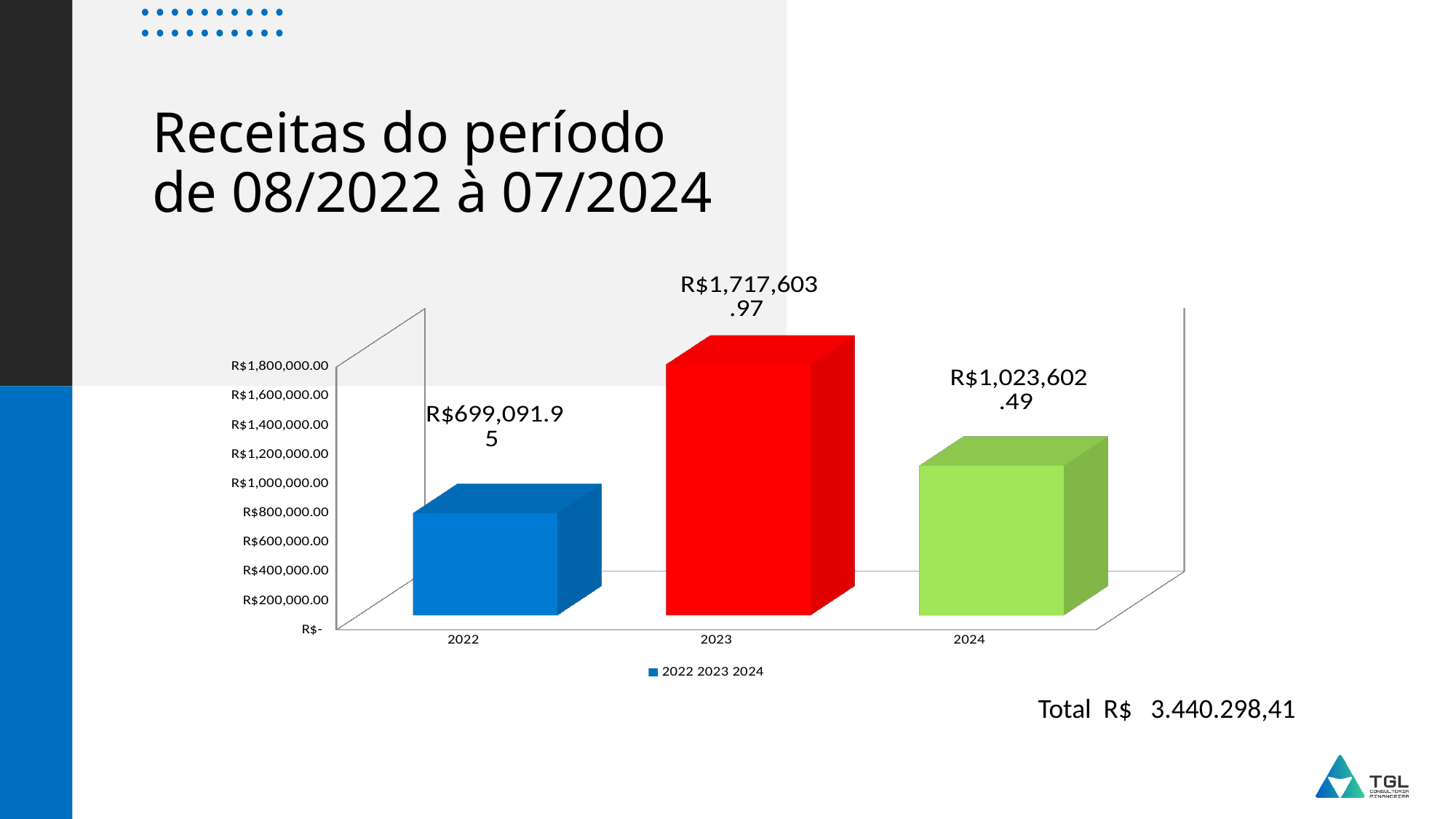
Is the value for 2023 greater or less than R$1,600,000.00? greater What is the value for 2023? R$1,717,603.97 Which year has the highest value? 2023 Does the value rise or fall from 2023 to 2024? fall How many years are shown on the x axis? 3 What is the difference between the values for 2023 and 2022? R$1,018,512.02 What is the value for 2024? R$1,023,602.49 What kind of chart is shown? bar chart Which year has the lowest value? 2022 What is the difference between the values for 2024 and 2022? R$324,510.54 What is the value for 2022? R$699,091.95 Which is larger, the value for 2024 or the value for 2022? 2024